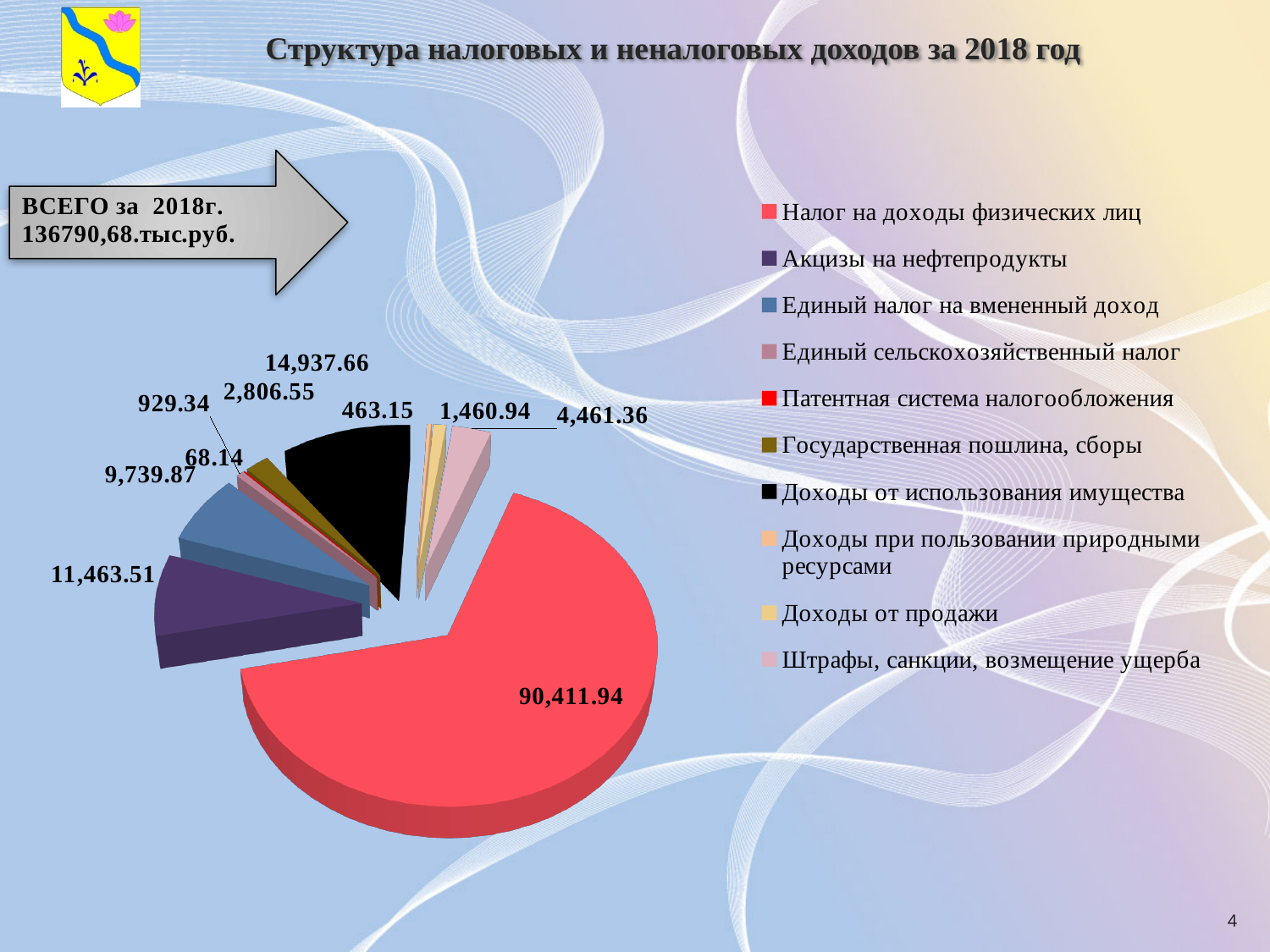
What is the difference between the values for Доходы от использования имущества and Акцизы на нефтепродукты? 3,474.15 What is the value shown for Акцизы на нефтепродукты? 11,463.51 Which category has the largest slice of the pie? Налог на доходы физических лиц What is the value shown for Налог на доходы физических лиц? 90,411.94 Which category has the smallest value in the pie chart? Патентная система налогообложения What is the value shown for Доходы от использования имущества? 14,937.66 What is the value shown for Штрафы, санкции, возмещение ущерба? 4,461.36 Which is larger: Доходы от продажи or Доходы при пользовании природными ресурсами? Доходы от продажи What is the difference between the values for Акцизы на нефтепродукты and Единый налог на вмененный доход? 1,723.64 What is the title of the slide containing the pie chart? Структура налоговых и неналоговых доходов за 2018 год How many categories does the legend of the pie chart list? 10 What type of chart is shown on the slide? Pie chart